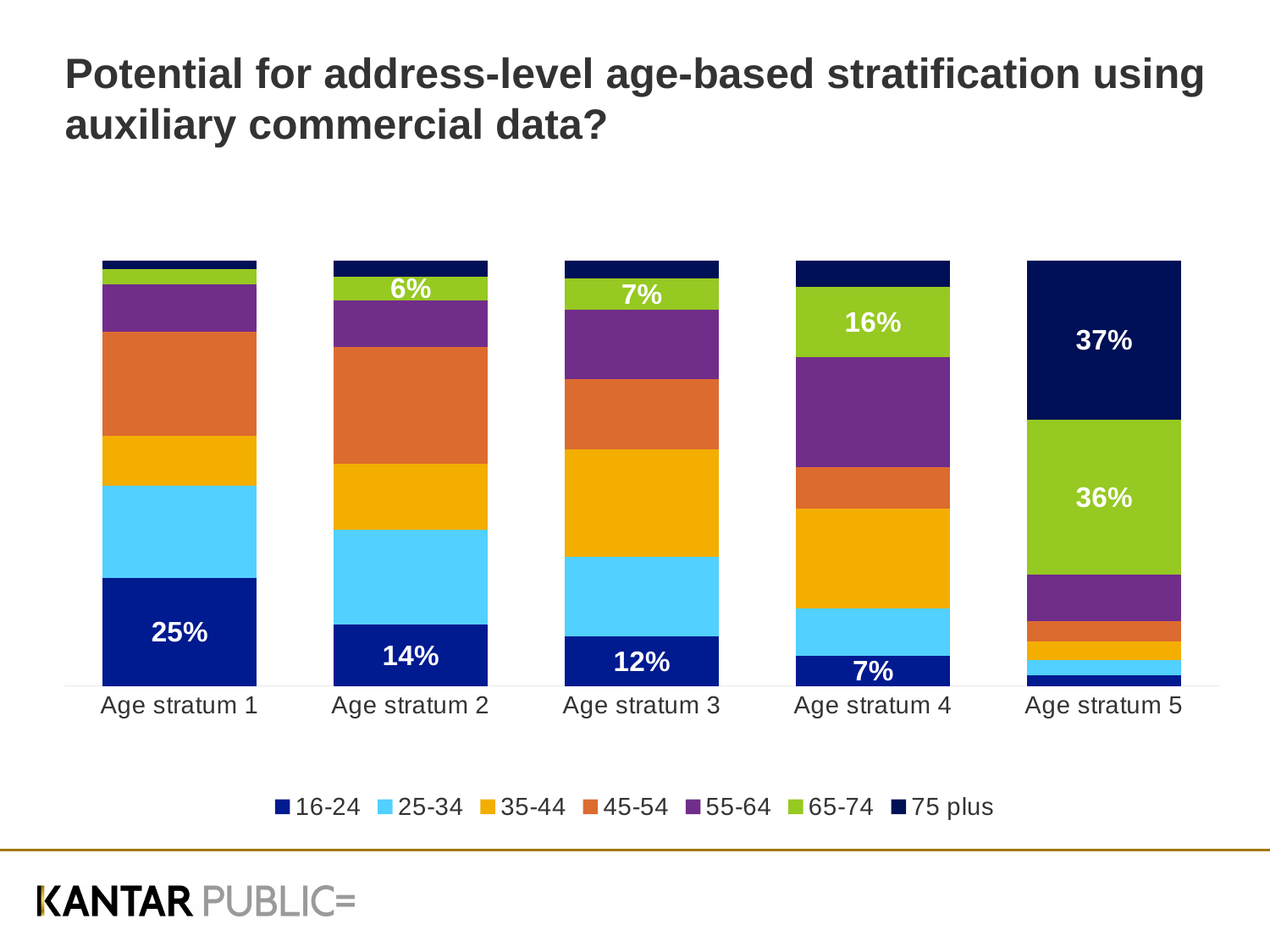
What is the value for the 16-24 series in Age stratum 3? 12% Which is larger in Age stratum 5: the 75 plus segment or the 65-74 segment? 75 plus How many age strata are shown on the x axis? 5 What is the value for the 75 plus series in Age stratum 5? 37% How many series does the legend list? 7 What is the value for the 65-74 series in Age stratum 4? 16% What is the value for the 16-24 series in Age stratum 1? 25% Which age stratum has the lowest labelled value for the 16-24 series? Age stratum 4 What is the value for the 65-74 series in Age stratum 2? 6% What is the difference between the 16-24 values for Age stratum 1 and Age stratum 2? 11% What kind of chart is shown on the slide? Stacked bar chart Which age stratum has the highest labelled value for the 16-24 series? Age stratum 1